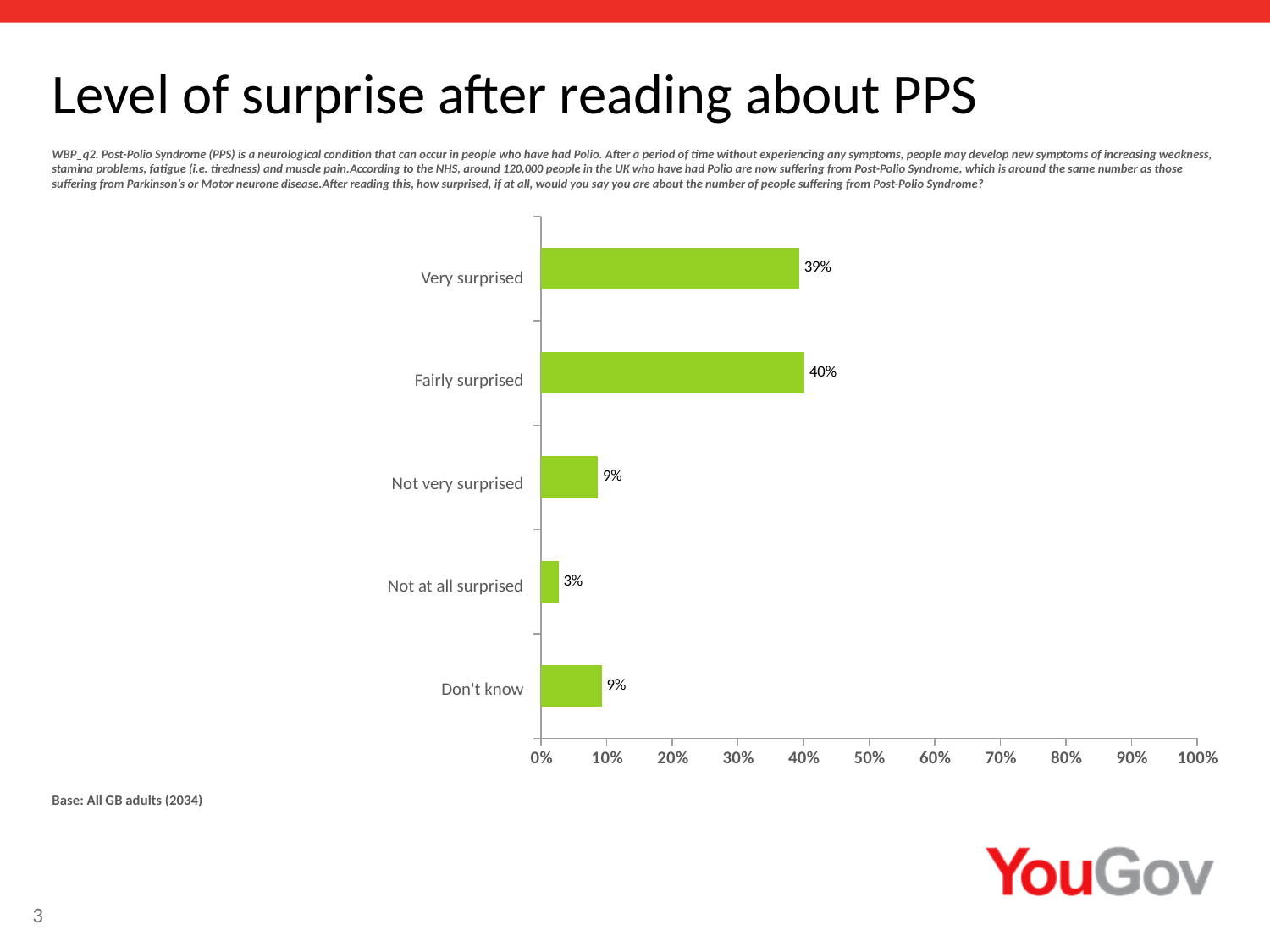
What is the difference between the 'Very surprised' and 'Not at all surprised' values? 36% What percentage of respondents said they were not at all surprised? 3% What is the base size stated below the chart? All GB adults (2034) Which is larger, the value for 'Very surprised' or the value for 'Not very surprised'? Very surprised What is the value for 'Don't know'? 9% What percentage of respondents said they were very surprised? 39% What is the difference between the 'Fairly surprised' and 'Not very surprised' values? 31% Is the value for 'Fairly surprised' greater or less than 30%? greater How many categories are shown on the chart? 5 Which category has the lowest value? Not at all surprised What is the value for 'Fairly surprised'? 40% What kind of chart is shown on the slide? Bar chart